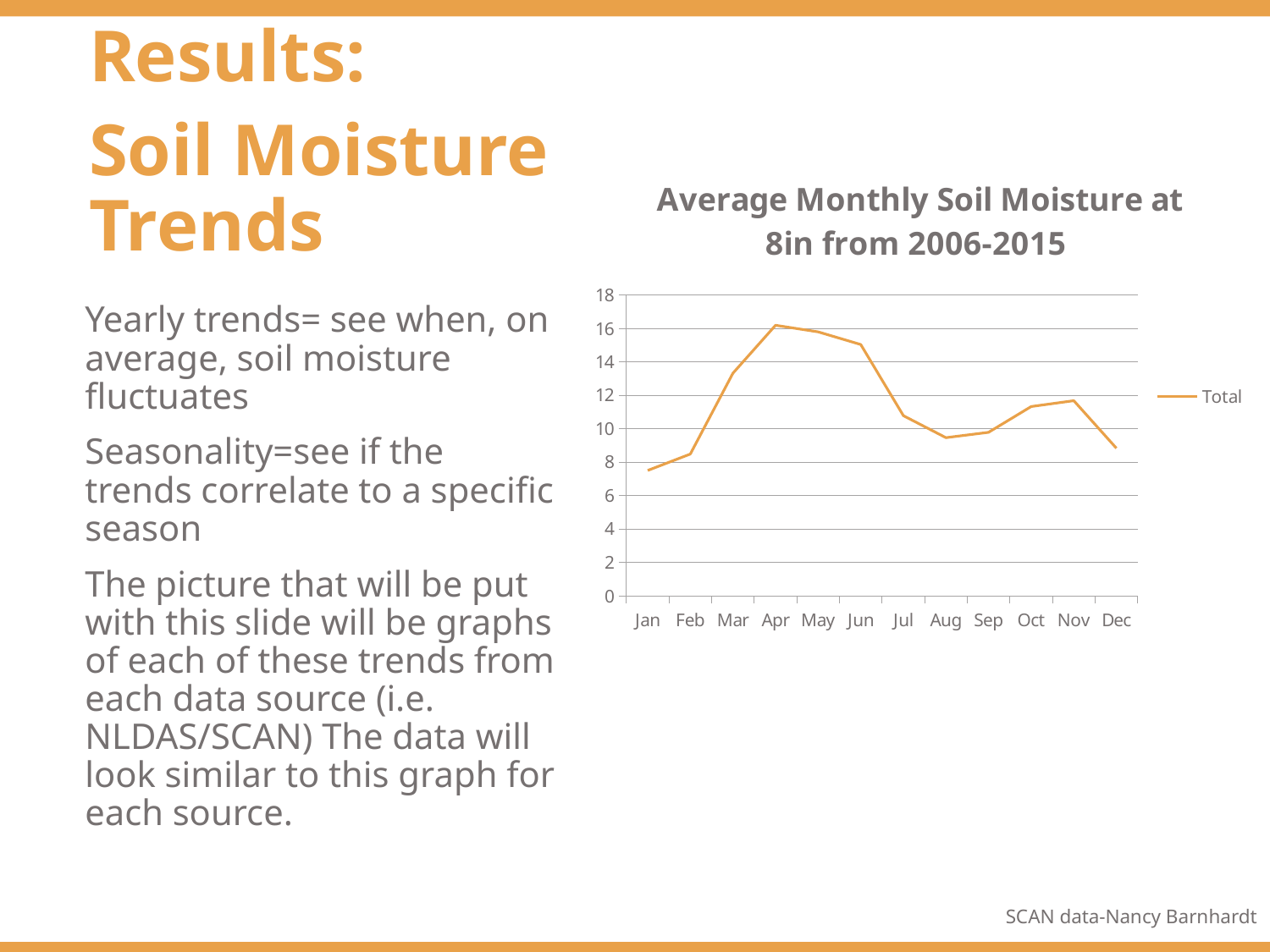
What is the title of the chart? Average Monthly Soil Moisture at 8in from 2006-2015 Do the values rise or fall from Jan to Apr? rise Which month has a larger value, Jun or Jul? Jun Is the value for Aug greater or less than 10? less Which month has the lowest average soil moisture value? Jan Is the value for Jan greater or less than 8? less What kind of chart is shown on the slide? line chart How many months are plotted along the x axis of the chart? 12 What is the name of the series shown in the legend? Total How many series does the chart's legend list? 1 Which month has the highest average soil moisture value? Apr